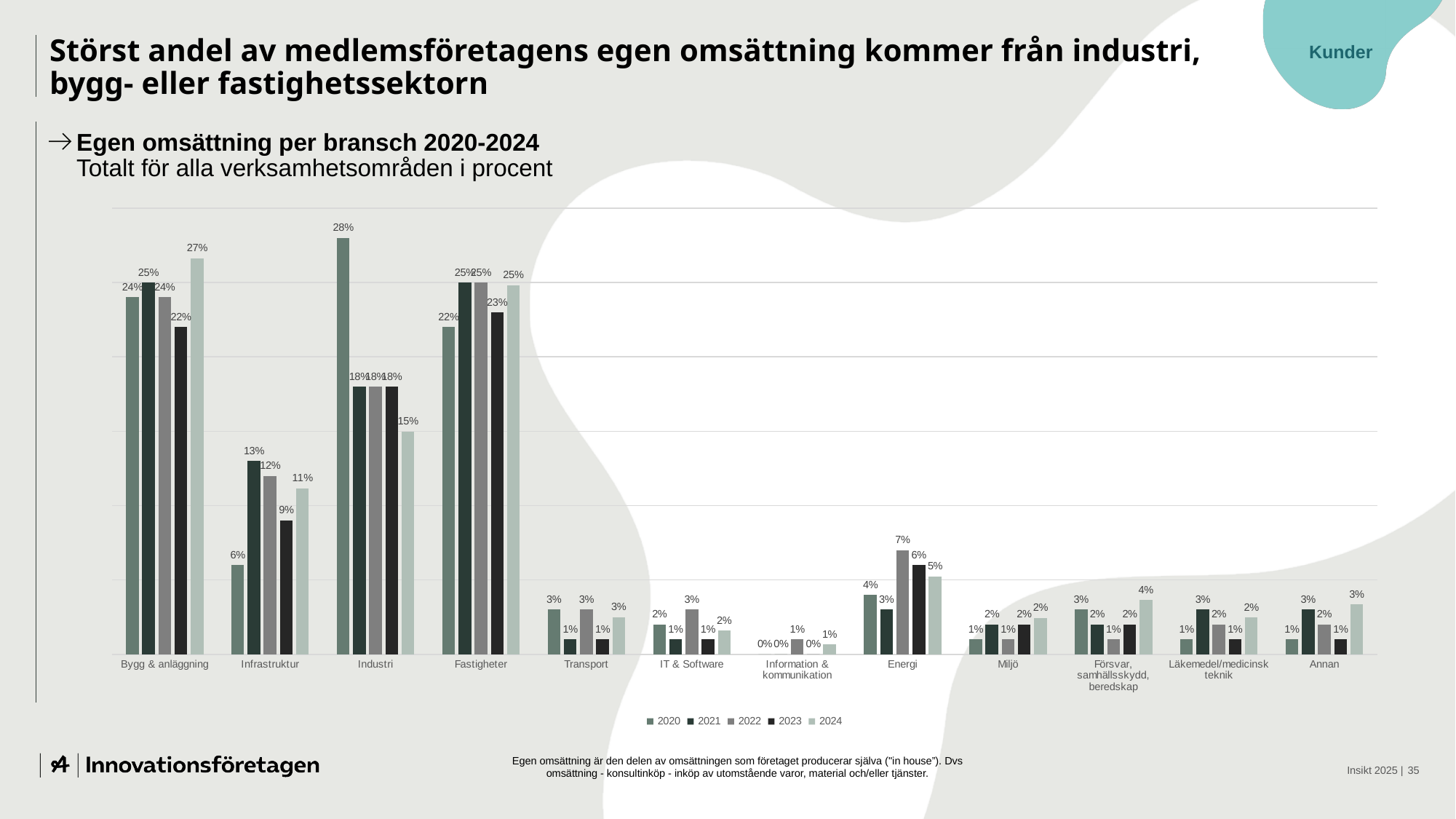
What is the value for Infrastruktur in 2023? 9% Which category has the lowest value in 2023? Information & kommunikation Which category has the highest value in 2020? Industri What kind of chart is shown on the slide? Bar chart What is the value for Energi in 2022? 7% How many series does the legend list? 5 Which is larger for Infrastruktur: the 2021 value or the 2024 value? 2021 What is the value for Bygg & anläggning in 2024? 27% What is the value for Industri in 2020? 28% Do the values for Industri rise or fall from 2020 to 2024? Fall What is the difference between the 2020 and 2024 values for Industri? 13% How many categories are shown on the x axis? 12